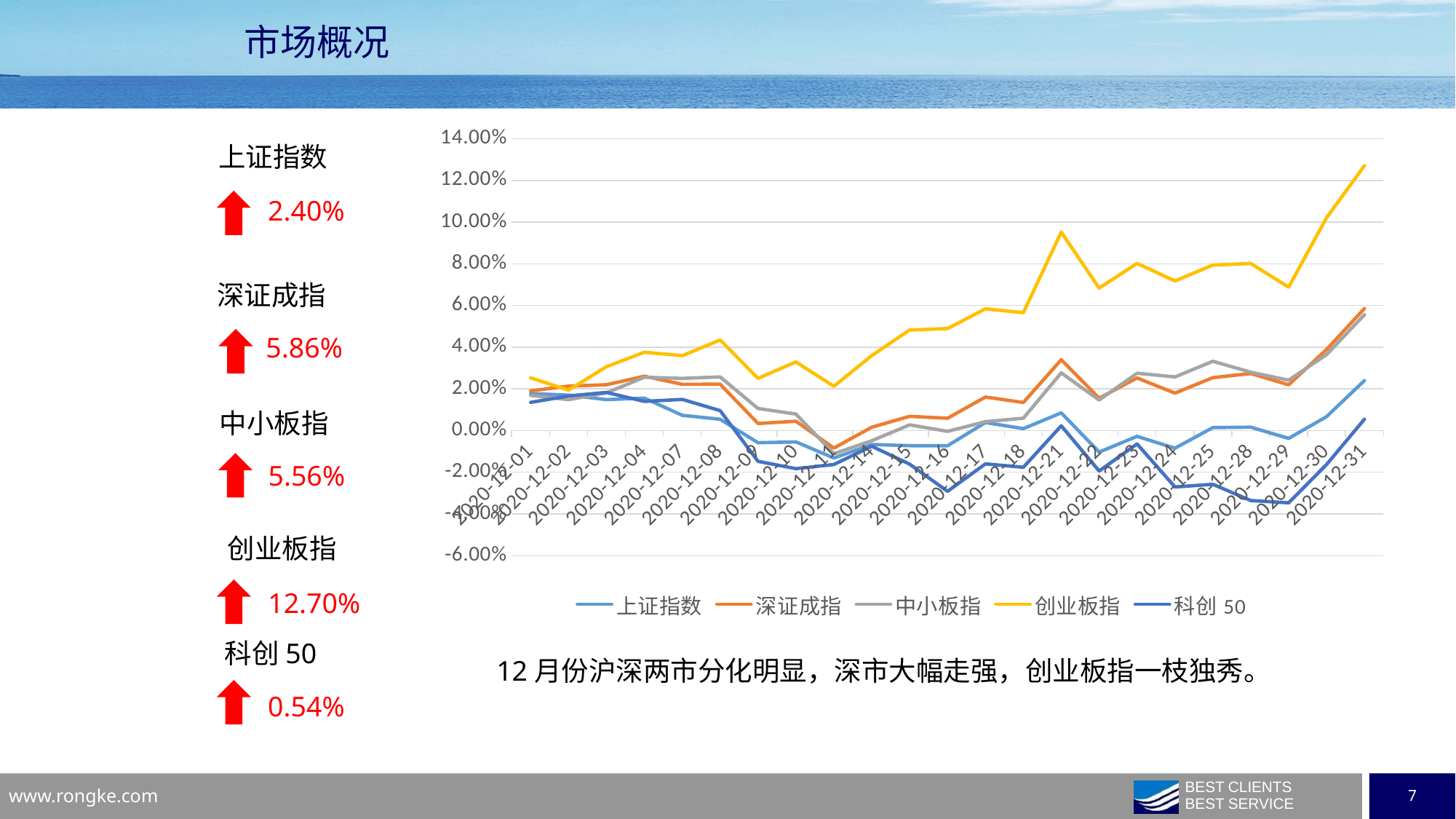
Is the value for 科创 50 at 2020-12-29 greater or less than -2.00%? less Which series has the highest value at 2020-12-31? 创业板指 What kind of chart is shown on the slide? line chart Is the value for 创业板指 at 2020-12-21 greater or less than 8.00%? greater At 2020-12-31, which is larger, 创业板指 or 上证指数? 创业板指 Which series has the highest value at 2020-12-21? 创业板指 Which series has the lowest value at 2020-12-31? 科创 50 Is the value for 深证成指 at 2020-12-11 greater or less than 0.00%? less According to the figures printed on the slide, what is the monthly change for 创业板指? 12.70% How many dates are shown along the x axis of the chart? 23 Does the 创业板指 line rise or fall from 2020-12-29 to 2020-12-31? rise How many series does the legend of the chart list? 5